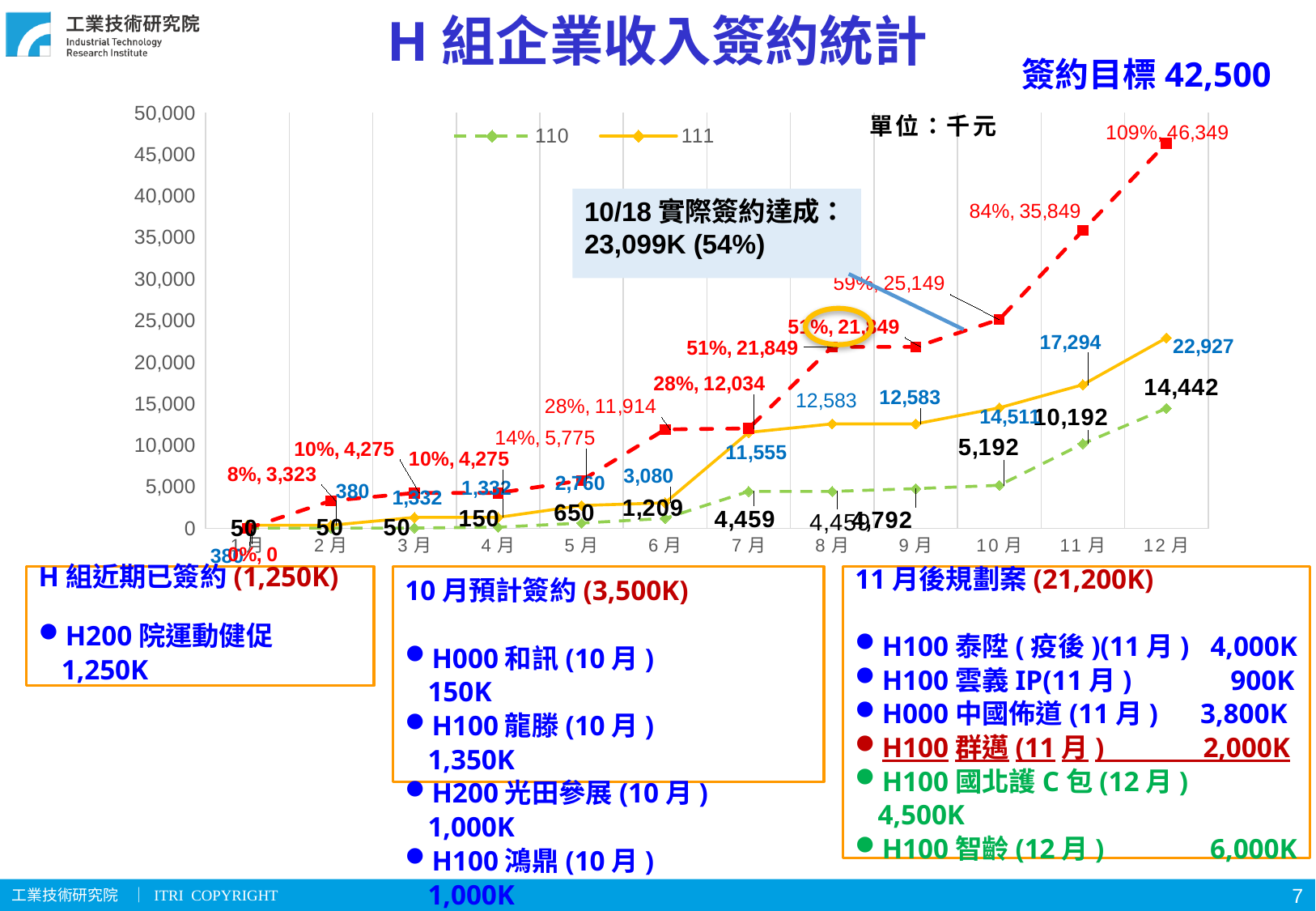
What is the value of series 111 in 12月? 22,927 What is the value of series 110 in 12月? 14,442 How many months are shown along the x axis of the chart? 12 In which month does series 111 reach its highest value? 12月 What is the difference between series 111 and series 110 in 12月? 8,485 What is the value of series 110 in 10月? 5,192 How many series does the chart legend list? 2 Which series has the larger value in 7月, 110 or 111? 111 Is the value of series 111 in 12月 greater or less than 20,000? greater What type of chart is shown on the slide? line chart Do the values of series 111 generally rise or fall from 1月 to 12月? rise What is the value of series 111 in 11月? 17,294